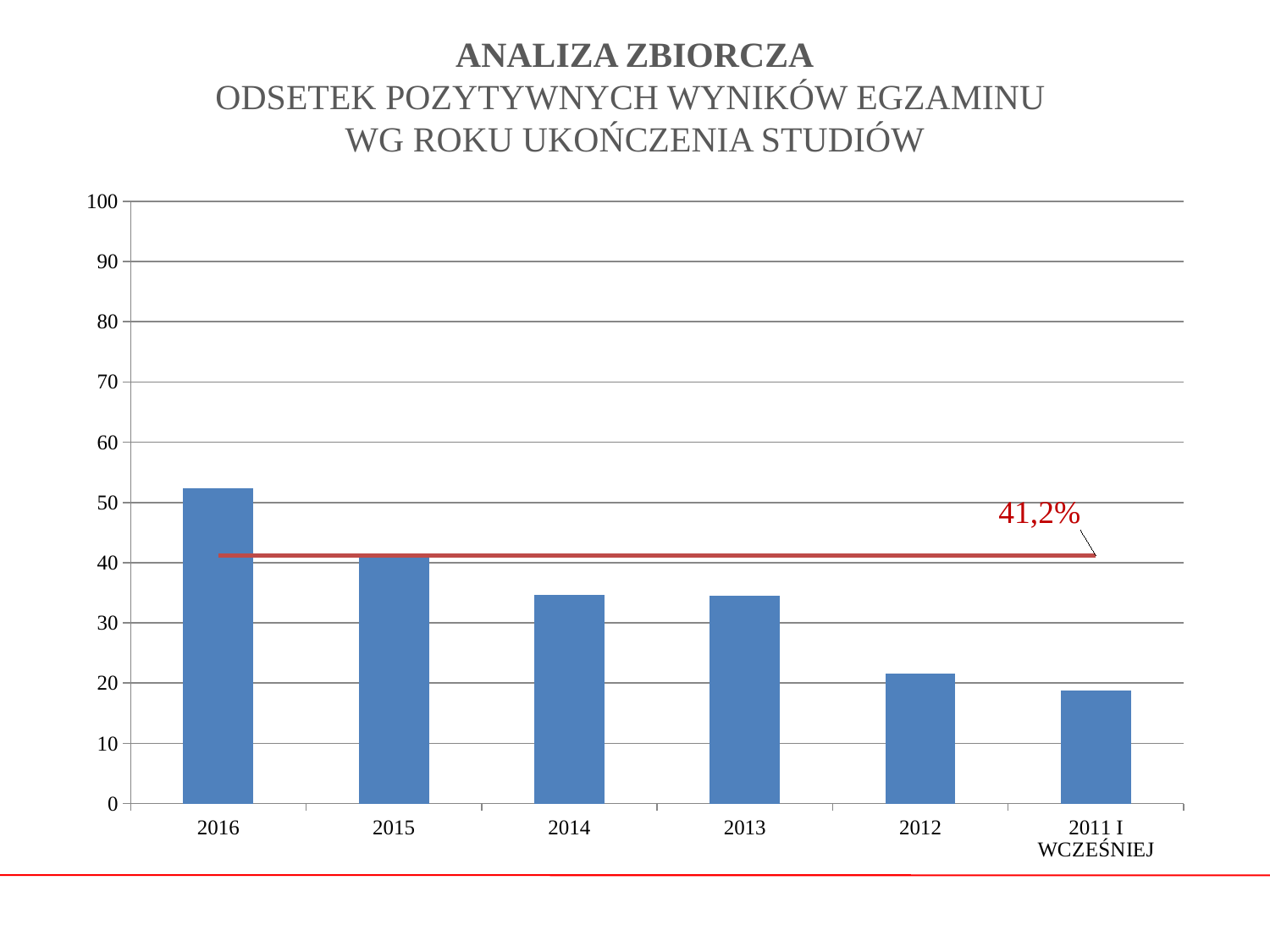
Which has the larger value, 2016 or 2015? 2016 Do the bar values rise or fall moving from 2016 on the left to 2011 I WCZEŚNIEJ on the right? fall How many categories are shown on the x axis of the chart? 6 Which category has the lowest bar in the chart? 2011 I WCZEŚNIEJ Is the value for 2011 I WCZEŚNIEJ greater or less than 20? less What kind of chart is shown on the slide? bar chart Which has the larger value, 2012 or 2011 I WCZEŚNIEJ? 2012 Which category has the highest bar in the chart? 2016 Is the value for 2016 greater or less than 50? greater Is the value for 2014 greater or less than 40? less What value is labelled on the red horizontal line drawn across the chart? 41,2%